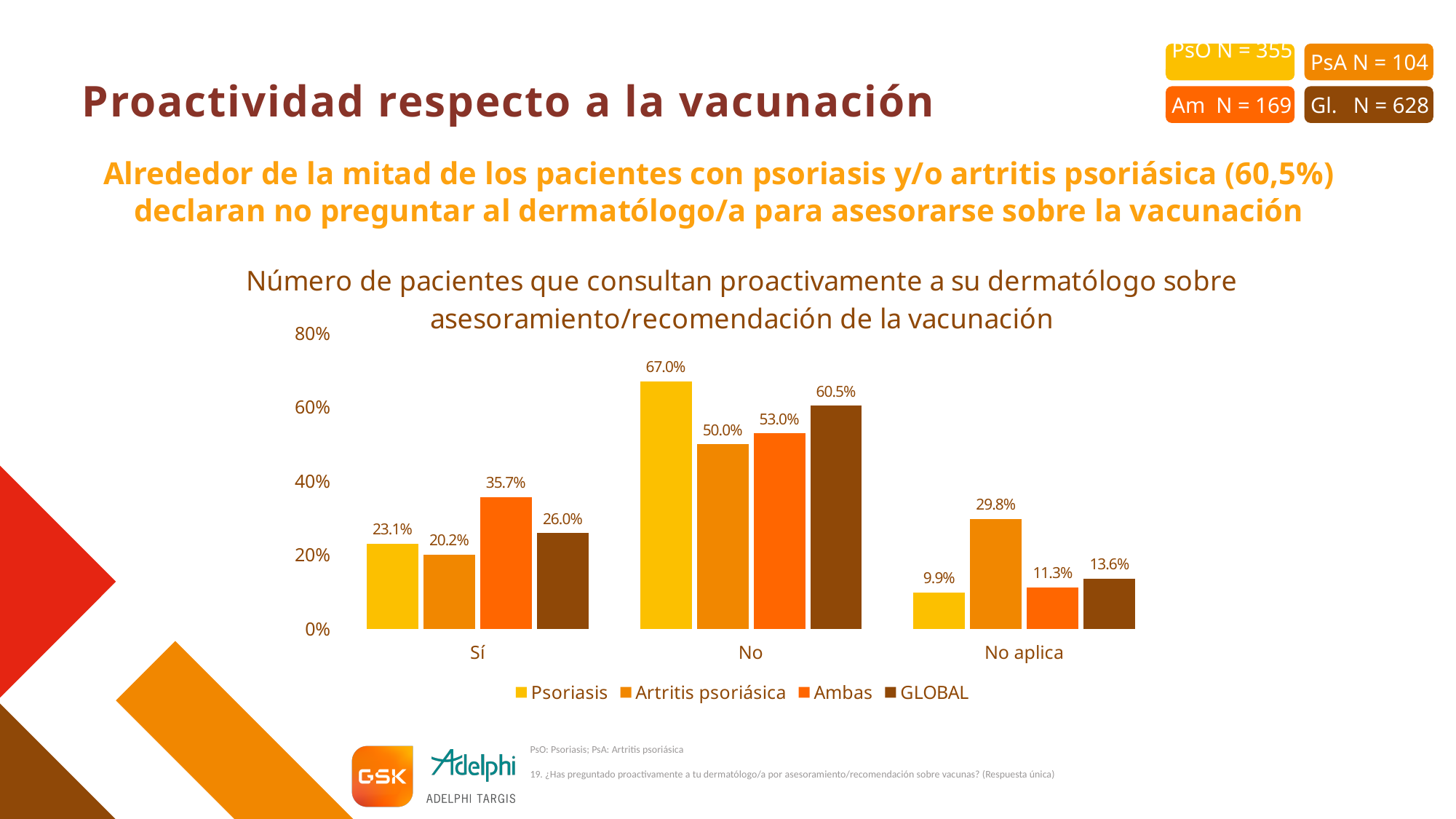
Which series has the highest value in the 'Sí' category? Ambas How many categories are shown on the x axis? 3 Which colour represents the GLOBAL series in the chart? Dark brown What is the value for Ambas in the 'No aplica' category? 11.3% How many series does the legend list? 4 What is the value for Psoriasis in the 'No' category? 67.0% What is the difference between the Psoriasis and Artritis psoriásica values in the 'No' category? 17.0% What is the value for Artritis psoriásica in the 'Sí' category? 20.2% Which is larger: the Ambas value for 'No' or the GLOBAL value for 'No'? GLOBAL What is the GLOBAL value for the 'Sí' category? 26.0% Which series has the lowest value in the 'No aplica' category? Psoriasis What kind of chart is shown on the slide? Bar chart